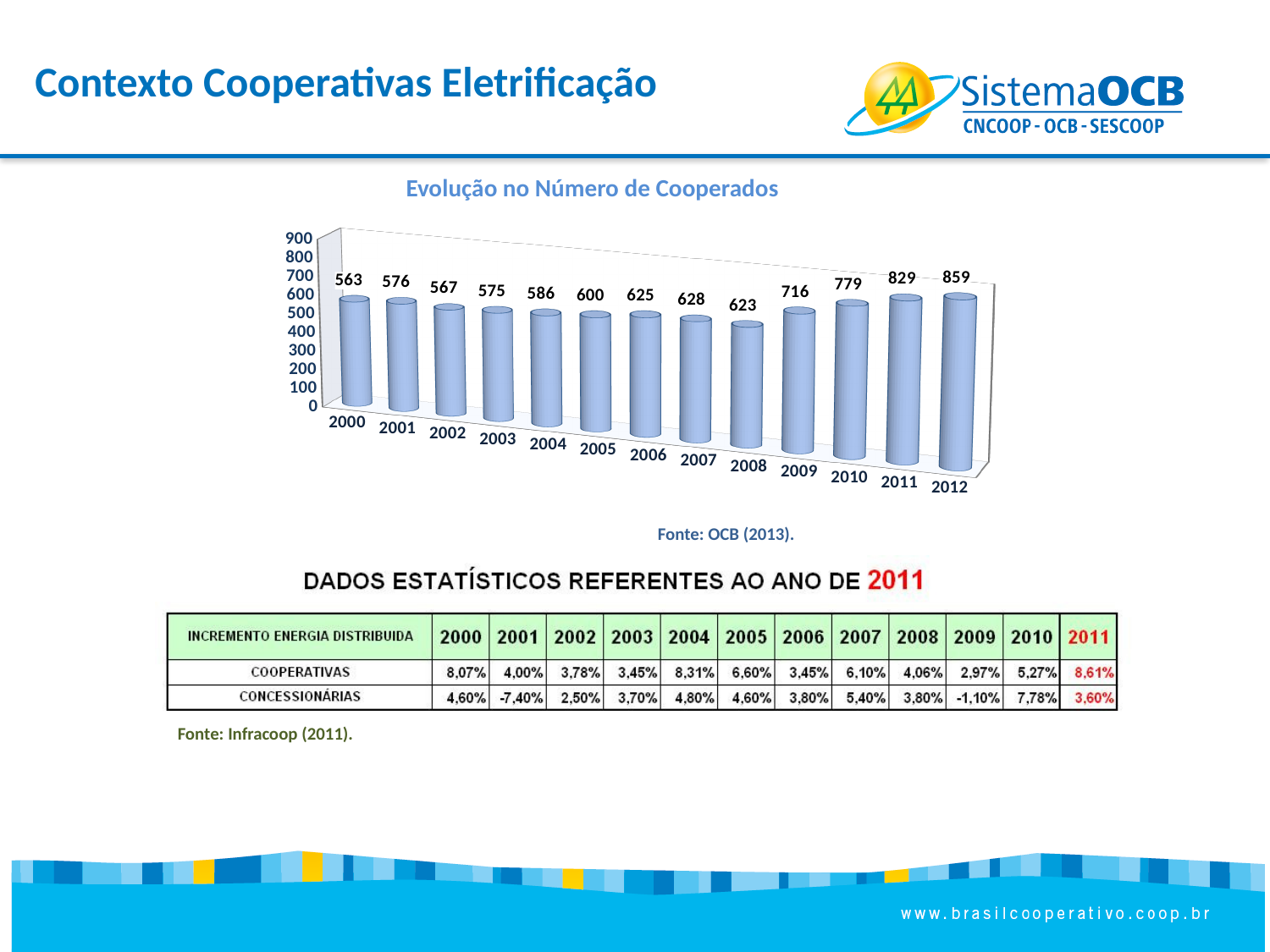
What is the value for 2012 in the chart 'Evolução no Número de Cooperados'? 859 In the chart 'Evolução no Número de Cooperados', do the values generally rise or fall from 2000 to 2012? Rise In the chart 'Evolução no Número de Cooperados', is the value for 2011 greater or less than 800? greater What is the value for 2009 in the chart 'Evolução no Número de Cooperados'? 716 What is the difference between the values for 2012 and 2011 in the chart 'Evolução no Número de Cooperados'? 30 Which year has the highest value in the chart 'Evolução no Número de Cooperados'? 2012 What is the value for 2000 in the chart 'Evolução no Número de Cooperados'? 563 In the chart 'Evolução no Número de Cooperados', which is larger, the value for 2007 or the value for 2008? 2007 What kind of chart is 'Evolução no Número de Cooperados'? Bar chart What is the difference between the values for 2010 and 2009 in the chart 'Evolução no Número de Cooperados'? 63 Which year has the lowest value in the chart 'Evolução no Número de Cooperados'? 2000 How many years are shown on the x axis of the chart 'Evolução no Número de Cooperados'? 13